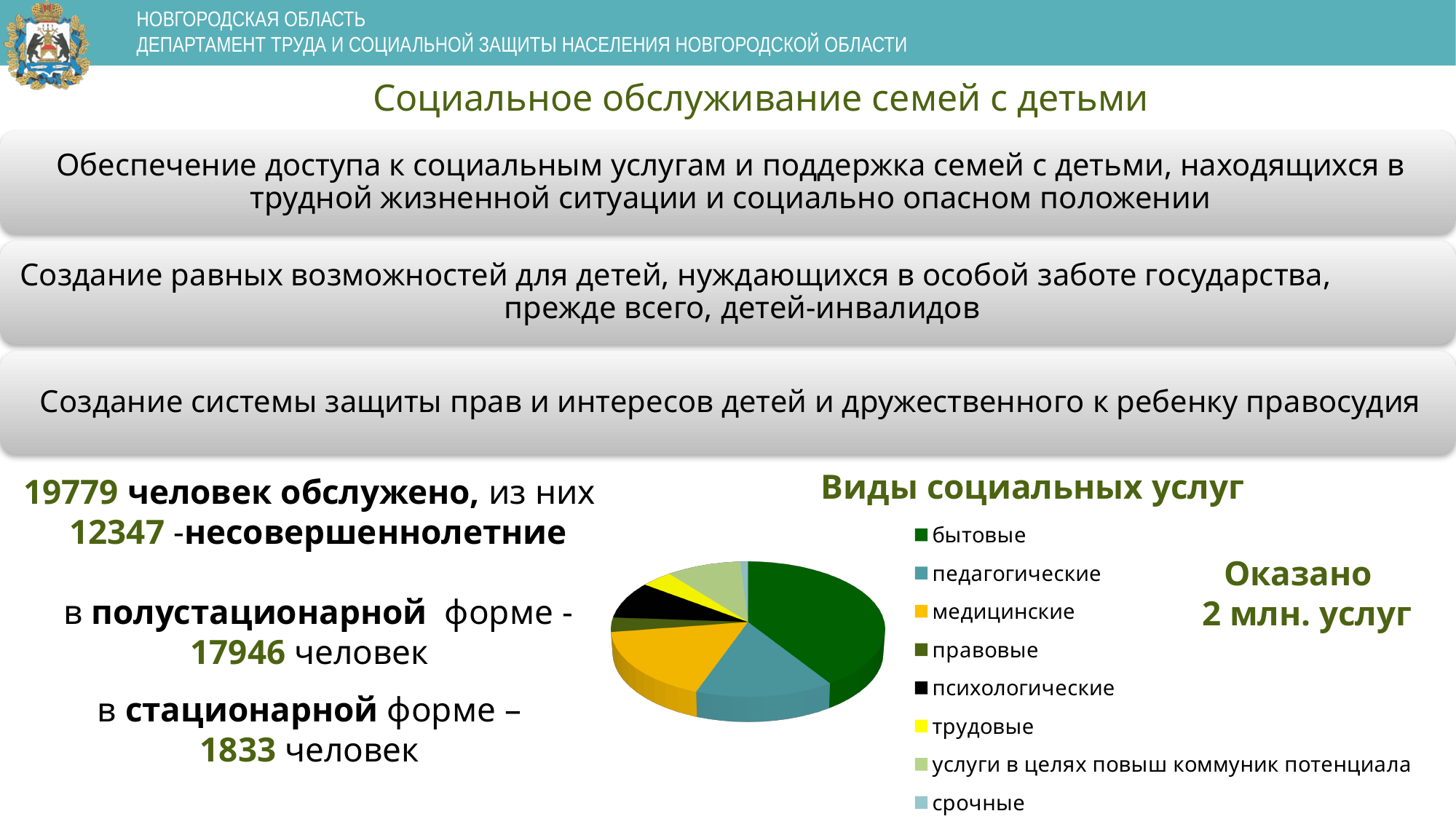
How many categories does the legend of the pie chart list? 8 Which category has the smallest slice in the pie chart? срочные In the pie chart, which slice is larger: психологические or срочные? психологические What is the title of the pie chart on the slide? Виды социальных услуг What colour is the бытовые slice in the pie chart? dark green In the pie chart, which slice is larger: бытовые or медицинские? бытовые What kind of chart is shown under the heading "Виды социальных услуг"? pie chart Which category has the largest slice in the pie chart? бытовые In the pie chart, which slice is larger: медицинские or трудовые? медицинские